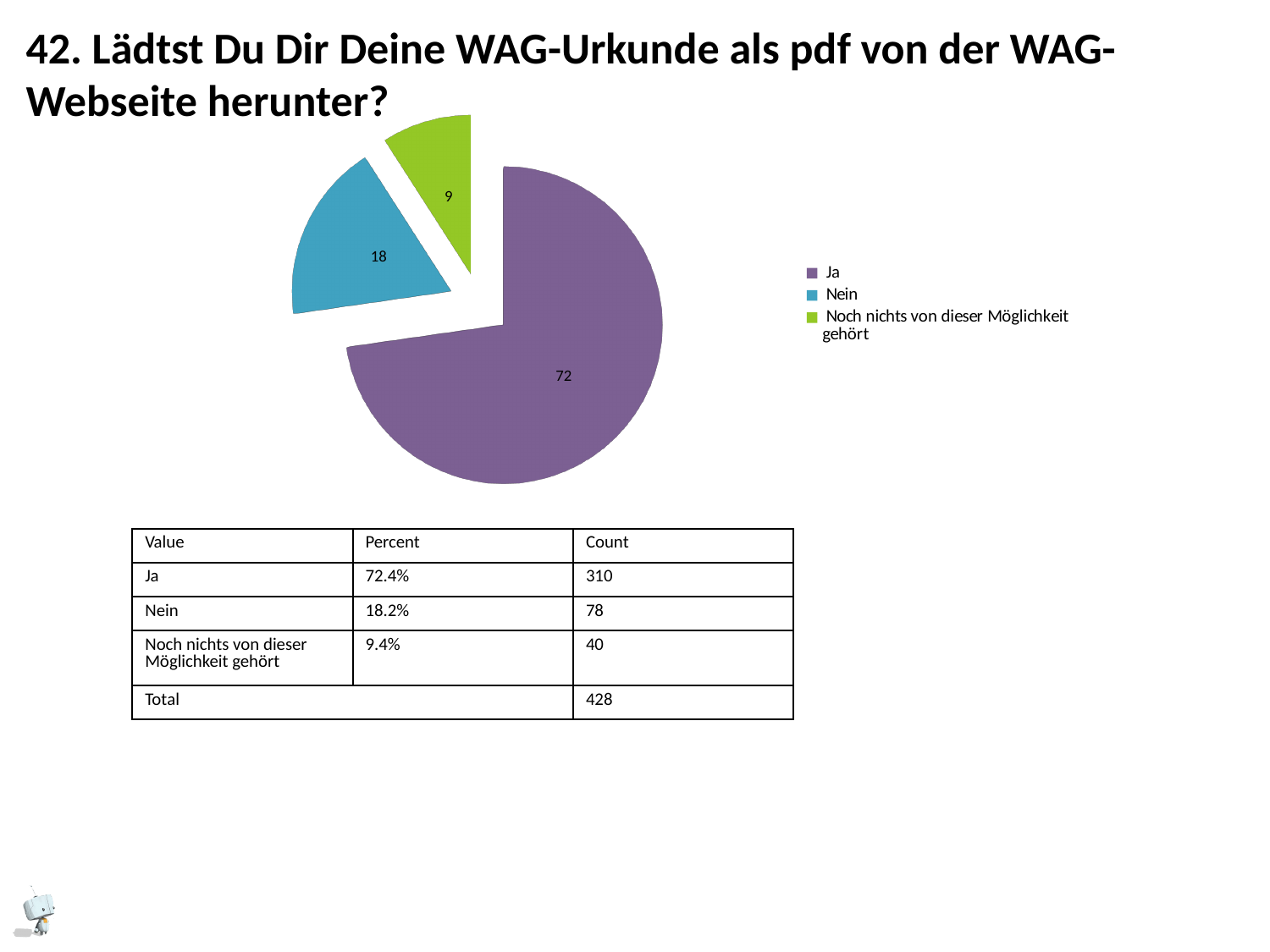
What is the difference between the values labelled on the "Ja" and "Nein" slices? 54 What colour is the "Nein" slice in the pie chart? Blue How many entries does the legend list? 3 What kind of chart is shown on the slide? Pie chart How many slices does the pie chart have? 3 What colour is the "Ja" slice in the pie chart? Purple Which slice is larger, "Nein" or "Noch nichts von dieser Möglichkeit gehört"? Nein Which category has the smallest slice of the pie? Noch nichts von dieser Möglichkeit gehört Which category has the largest slice of the pie? Ja What value is shown on the pie slice for "Noch nichts von dieser Möglichkeit gehört"? 9 What value is shown on the pie slice for "Nein"? 18 What value is shown on the pie slice for "Ja"? 72